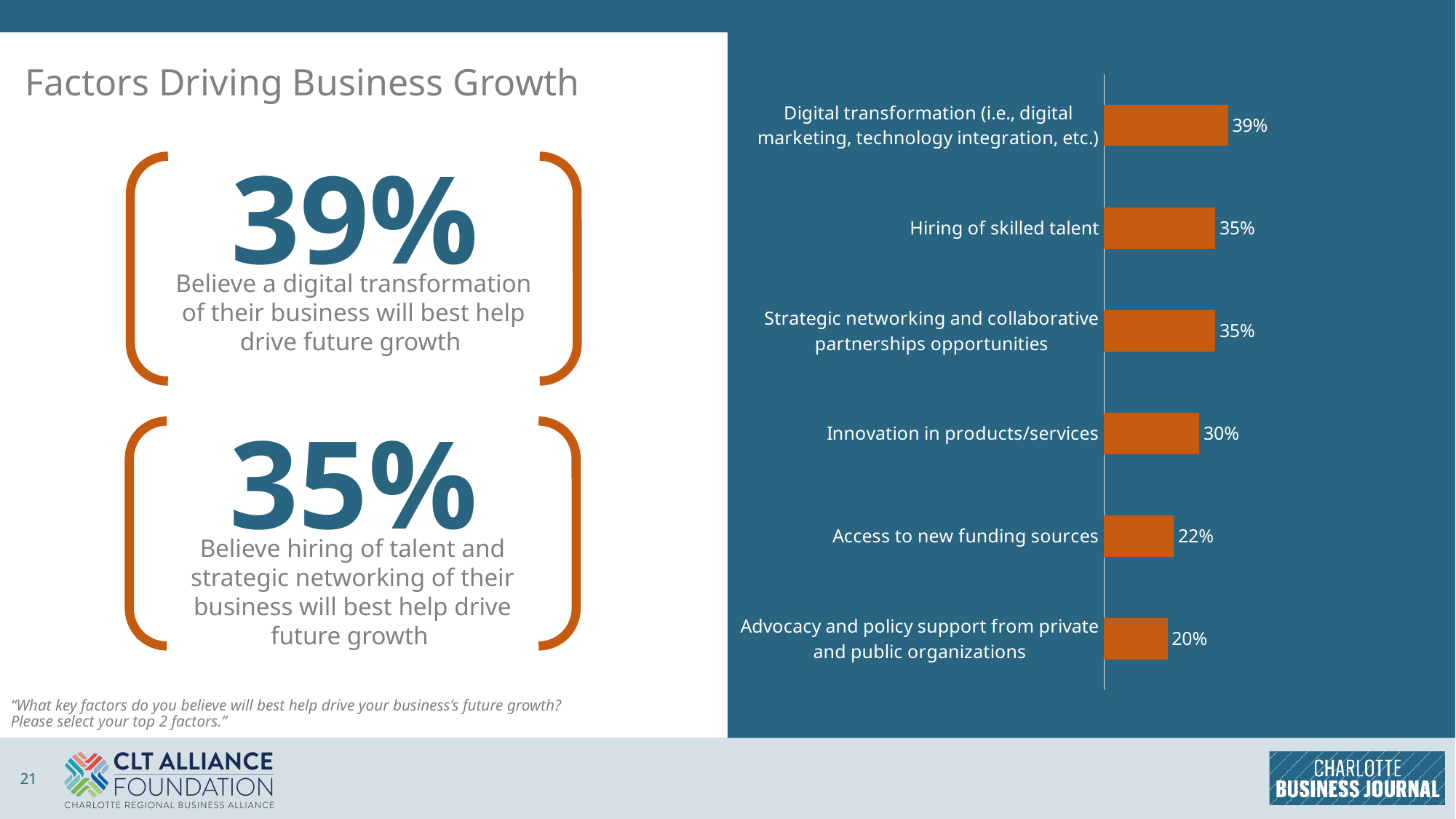
Which is larger: the value for Hiring of skilled talent or the value for Innovation in products/services? Hiring of skilled talent Which factor has the highest percentage in the chart? Digital transformation (i.e., digital marketing, technology integration, etc.) What is the difference between the percentage for Digital transformation and the percentage for Hiring of skilled talent? 4% What type of chart is shown on the slide? Bar chart How many factors are shown in the bar chart? 6 Which factor has the lowest percentage in the chart? Advocacy and policy support from private and public organizations What is the value shown for Access to new funding sources? 22% What is the value shown for Advocacy and policy support from private and public organizations? 20% What is the title of the slide containing the chart? Factors Driving Business Growth What percentage of respondents selected Digital transformation as a factor driving business growth? 39% What is the difference between the percentage for Innovation in products/services and the percentage for Access to new funding sources? 8% What is the value shown for Innovation in products/services? 30%